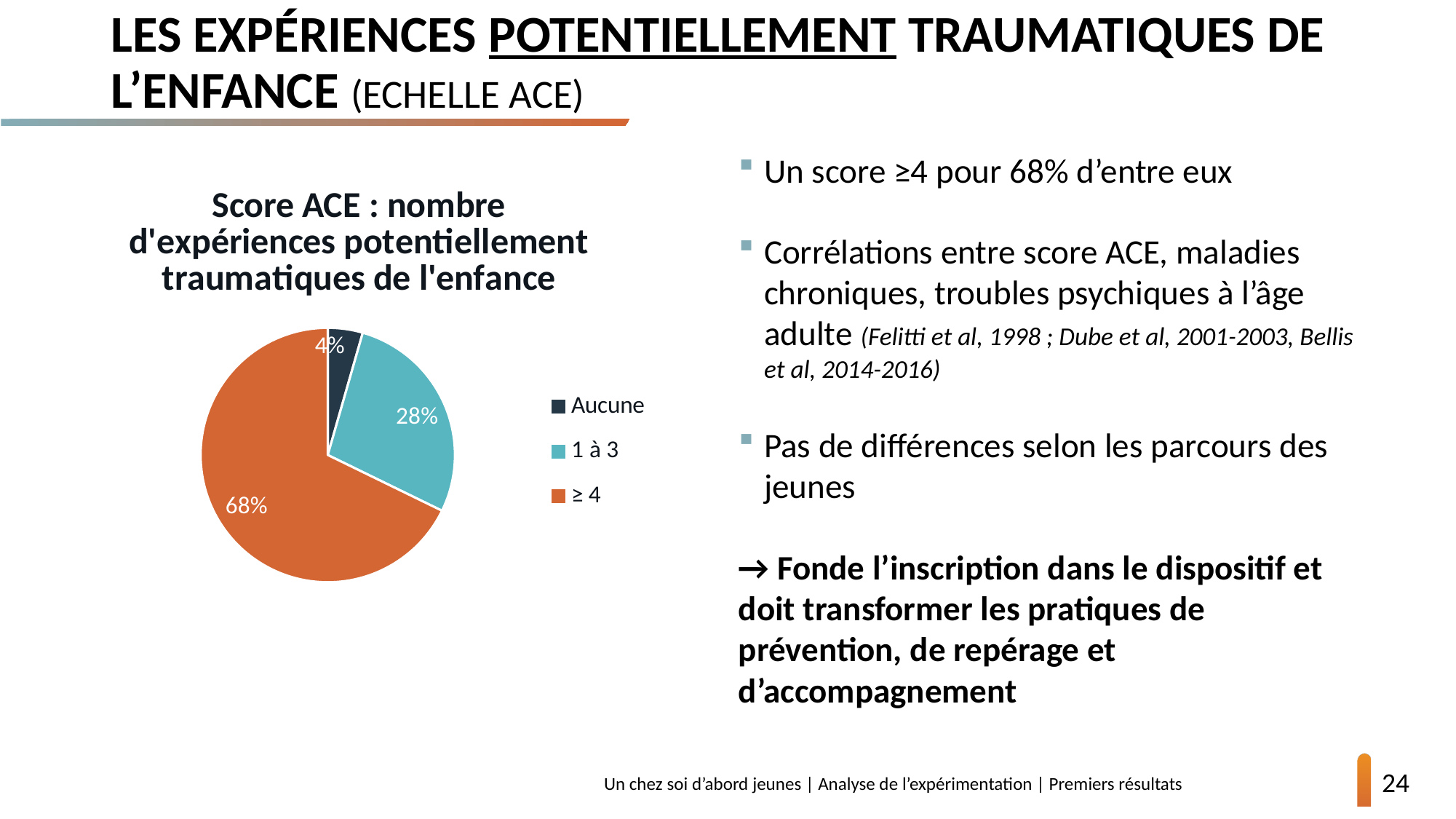
What share of the pie does the '1 à 3' slice represent? 28% What share of the pie does the '≥ 4' slice represent? 68% What is the combined share of the 'Aucune' and '1 à 3' slices? 32% Which category has the smallest slice of the pie? Aucune How many categories does the pie chart show? 3 What share of the pie does the 'Aucune' slice represent? 4% What colour is the '≥ 4' slice in the pie chart? orange What kind of chart is shown on the slide? pie chart What is the title of the pie chart? Score ACE : nombre d'expériences potentiellement traumatiques de l'enfance Which category has the largest slice of the pie? ≥ 4 Which slice is larger, '1 à 3' or 'Aucune'? 1 à 3 What is the difference in percentage points between the '≥ 4' slice and the '1 à 3' slice? 40%